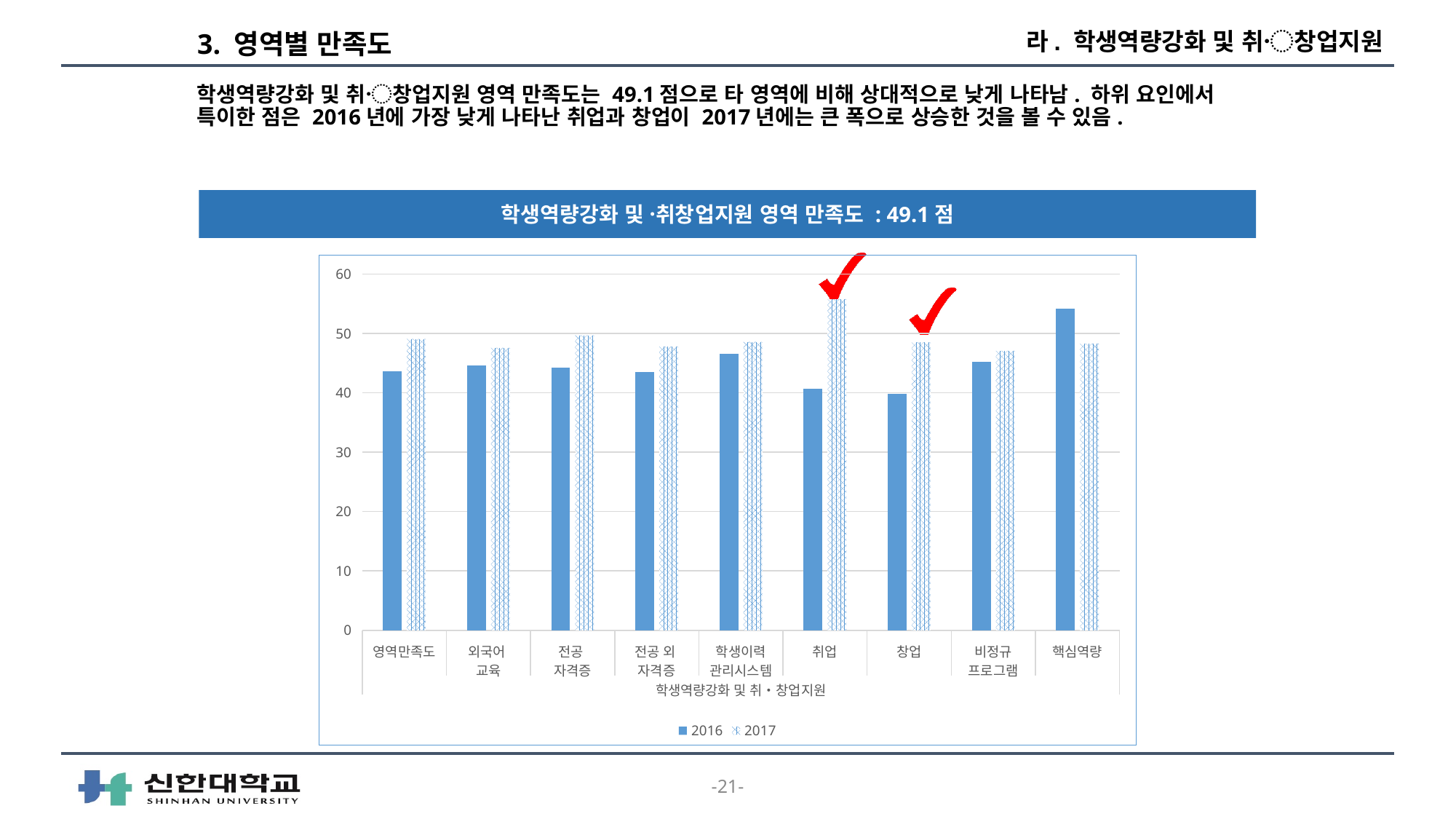
How many categories are shown along the x axis of the chart? 9 For 핵심역량, which series has the larger value, 2016 or 2017? 2016 Is the 2017 value for 취업 greater or less than 50? greater Which category has the highest value for the 2016 series? 핵심역량 Which category has the highest value for the 2017 series? 취업 What are the two series listed in the chart's legend? 2016, 2017 Is the 2016 value for 영역만족도 greater or less than 50? less For 창업, which series has the larger value, 2016 or 2017? 2017 What kind of chart is shown on the slide? bar chart For 취업, which series has the larger value, 2016 or 2017? 2017 How many series does the chart's legend list? 2 Is the 2016 value for 핵심역량 greater or less than 50? greater